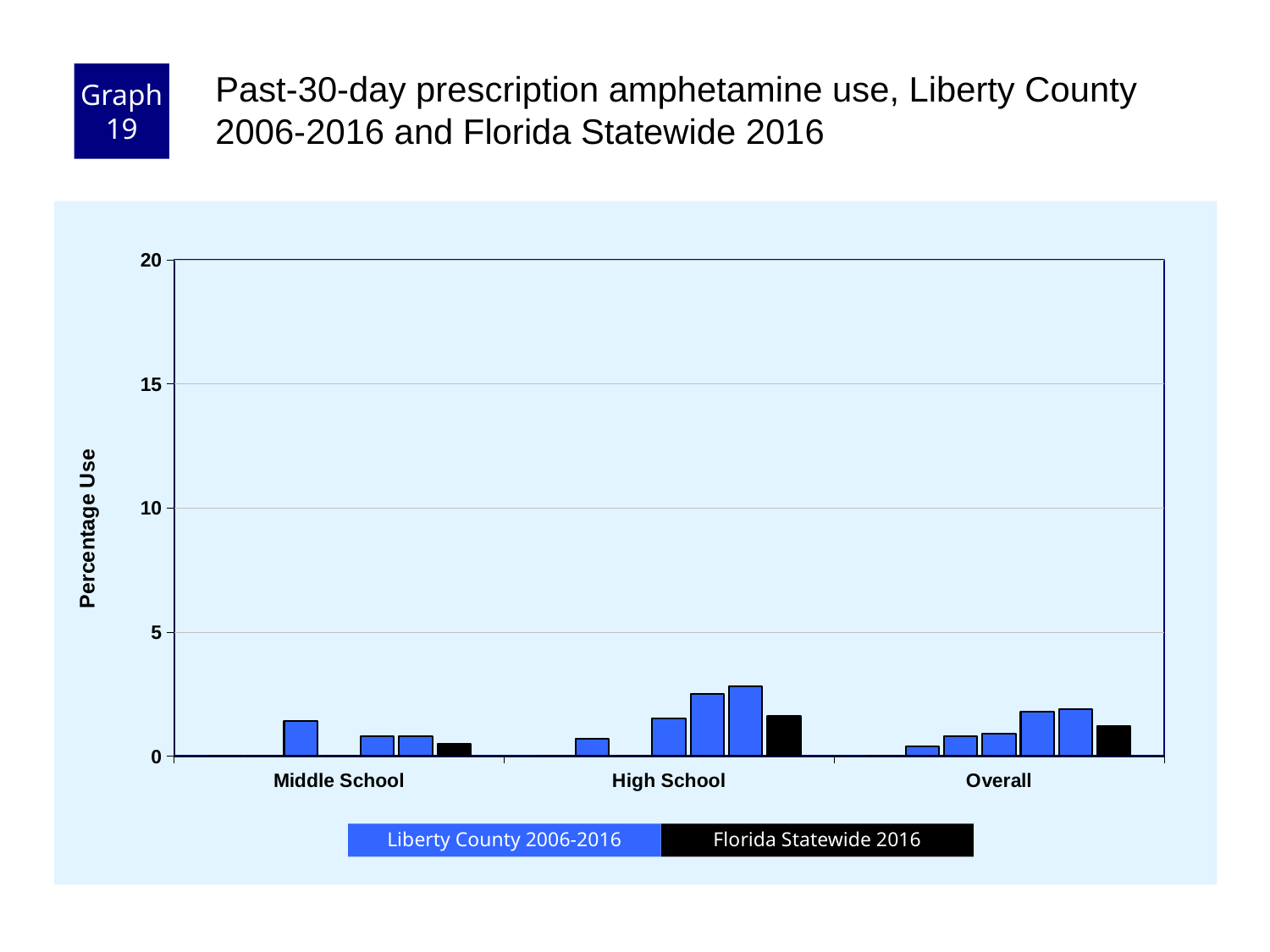
What colour are the Florida Statewide 2016 bars? black Which category has the lowest Florida Statewide 2016 value? Middle School What is the label of the y axis? Percentage Use Which category has the higher Florida Statewide 2016 value, Middle School or High School? High School Is the Florida Statewide 2016 value for Overall greater or less than 10? less How many series does the legend list? 2 What kind of chart is shown on the slide? bar chart How many categories are shown along the x axis? 3 Is the Florida Statewide 2016 value for Middle School greater or less than 5? less Which category has the highest Florida Statewide 2016 value? High School Is the tallest Liberty County 2006-2016 bar for High School greater or less than 5? less